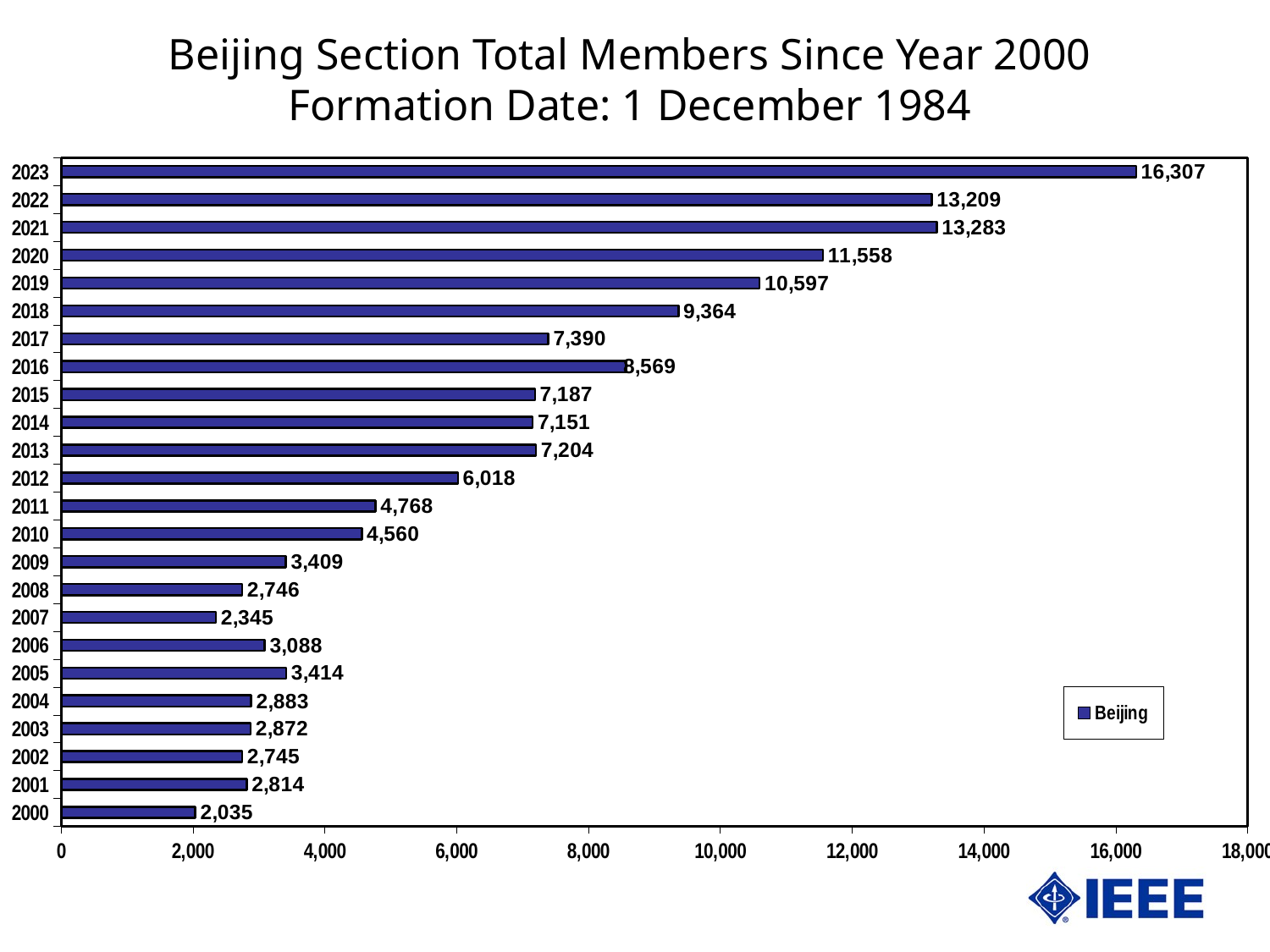
What is the value shown for 2007? 2,345 How many total members did the Beijing Section have in 2023? 16,307 Is the value for 2019 greater or less than 10,000? greater How many years are shown on the chart? 24 What kind of chart is shown on the slide? bar chart What is the difference between the values for 2023 and 2022? 3,098 Which year has the lowest number of members? 2000 What is the difference between the values for 2012 and 2011? 1,250 Which year has the highest number of members? 2023 How many series does the legend list? 1 What is the value shown for 2016? 8,569 Which year has the larger value, 2021 or 2022? 2021